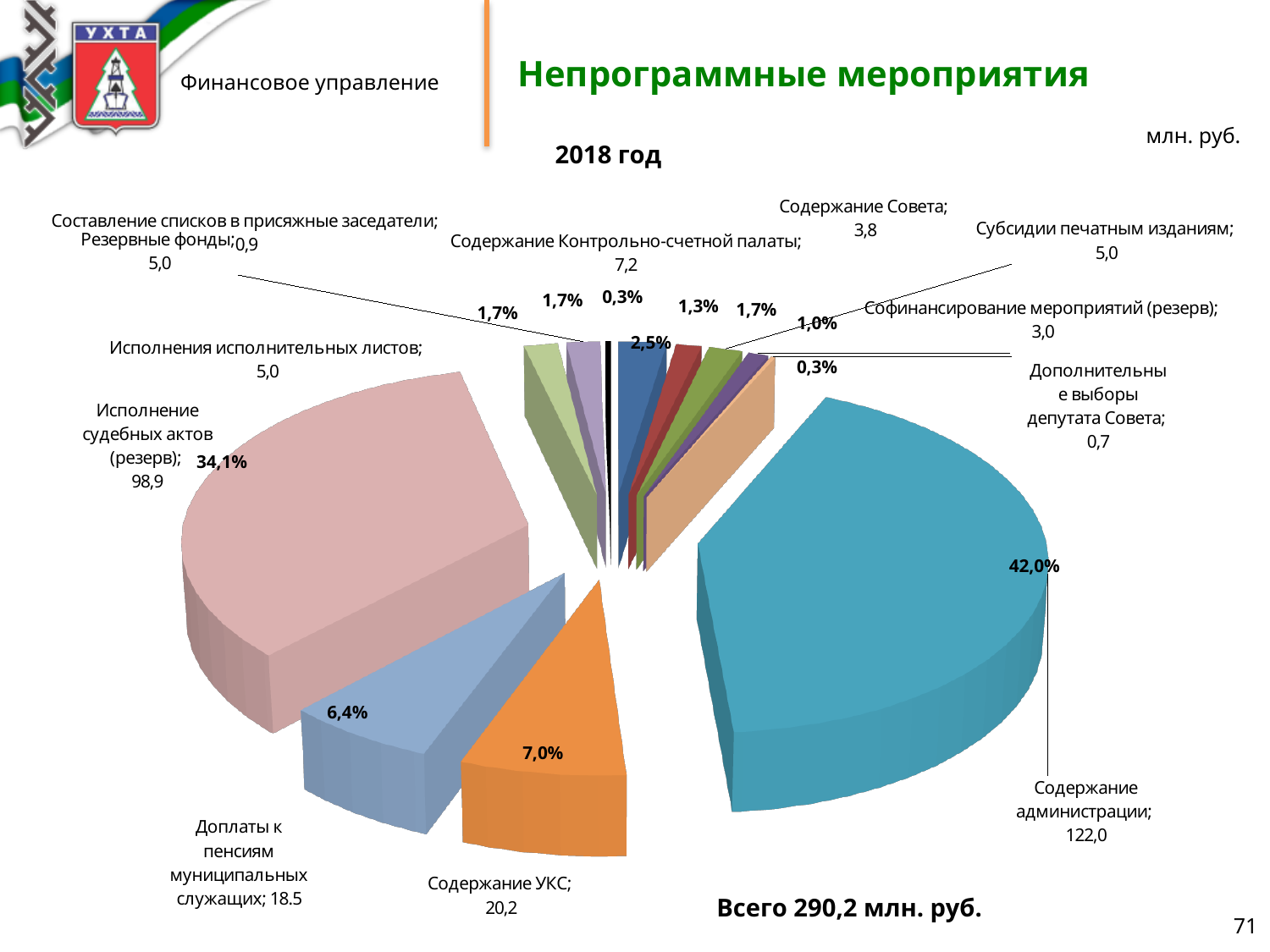
What is the total shown for all categories on the slide? 290,2 млн. руб. What share of the pie does Доплаты к пенсиям муниципальных служащих represent? 6,4% What is the difference between the values for Содержание администрации and Исполнение судебных актов (резерв)? 23,1 What share of the pie does Содержание администрации represent? 42,0% Which is larger: Содержание УКС or Доплаты к пенсиям муниципальных служащих? Содержание УКС What type of chart is shown on the slide? Pie chart What is the value for Содержание администрации? 122,0 What is the value for Содержание УКС? 20,2 Which category has the largest slice of the pie? Содержание администрации What is the value for Исполнение судебных актов (резерв)? 98,9 What is the value for Содержание Контрольно-счетной палаты? 7,2 Which category has the smallest value? Дополнительные выборы депутата Совета